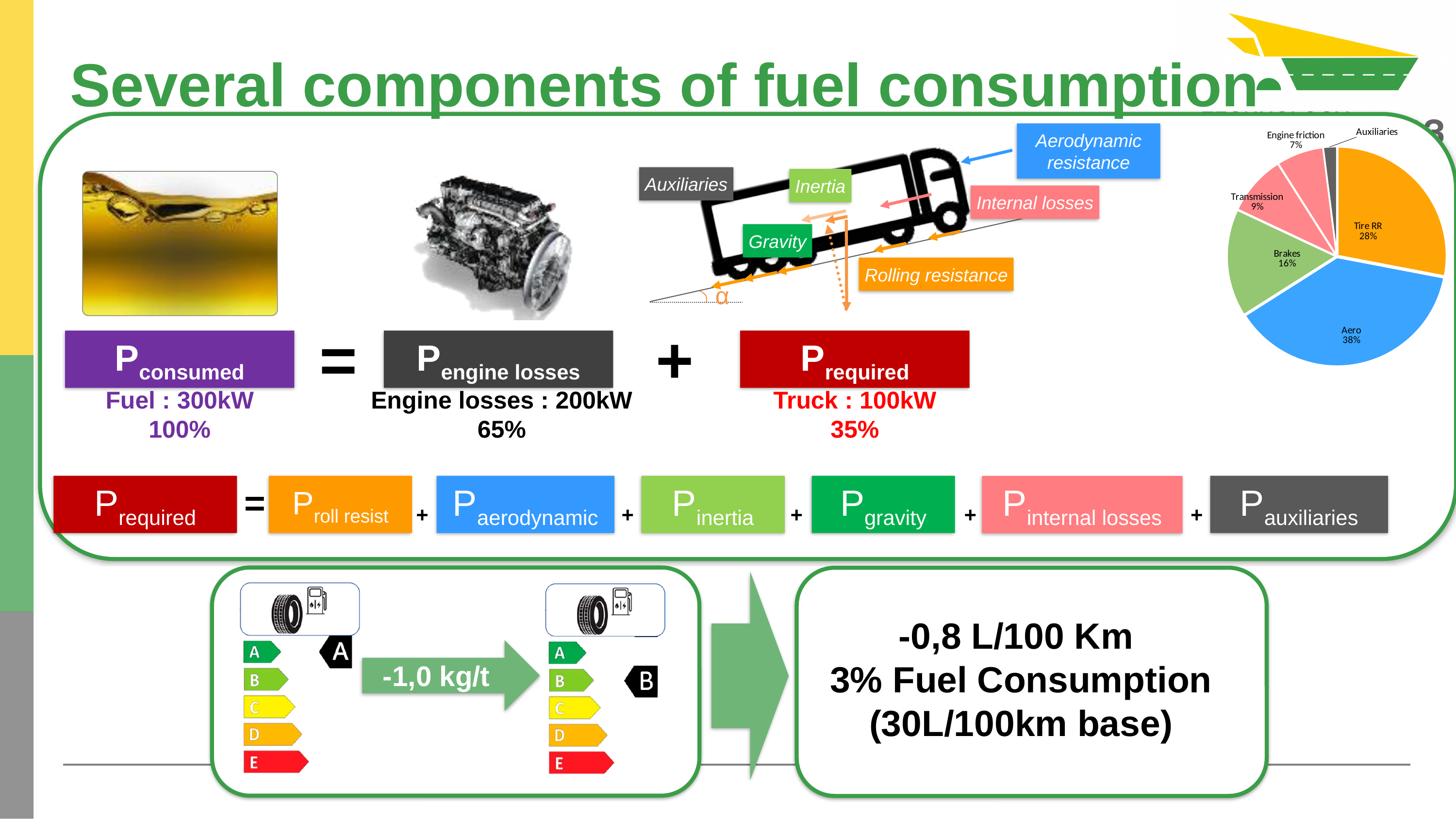
In the pie chart, what is the difference between the Brakes and Transmission percentages? 7% In the pie chart, what percentage is shown for Transmission? 9% What type of chart is shown in the top right of the slide? pie chart What colour is the Aero slice in the pie chart? blue In the pie chart, what percentage is shown for Engine friction? 7% Which slice of the pie chart is the smallest? Auxiliaries In the pie chart, what percentage is shown for Brakes? 16% Which slice of the pie chart is the largest? Aero In the pie chart, which is larger, Tire RR or Brakes? Tire RR In the pie chart, what is the difference between the Aero and Tire RR percentages? 10% In the pie chart, what percentage is shown for Tire RR? 28% In the pie chart, what percentage is shown for Aero? 38%